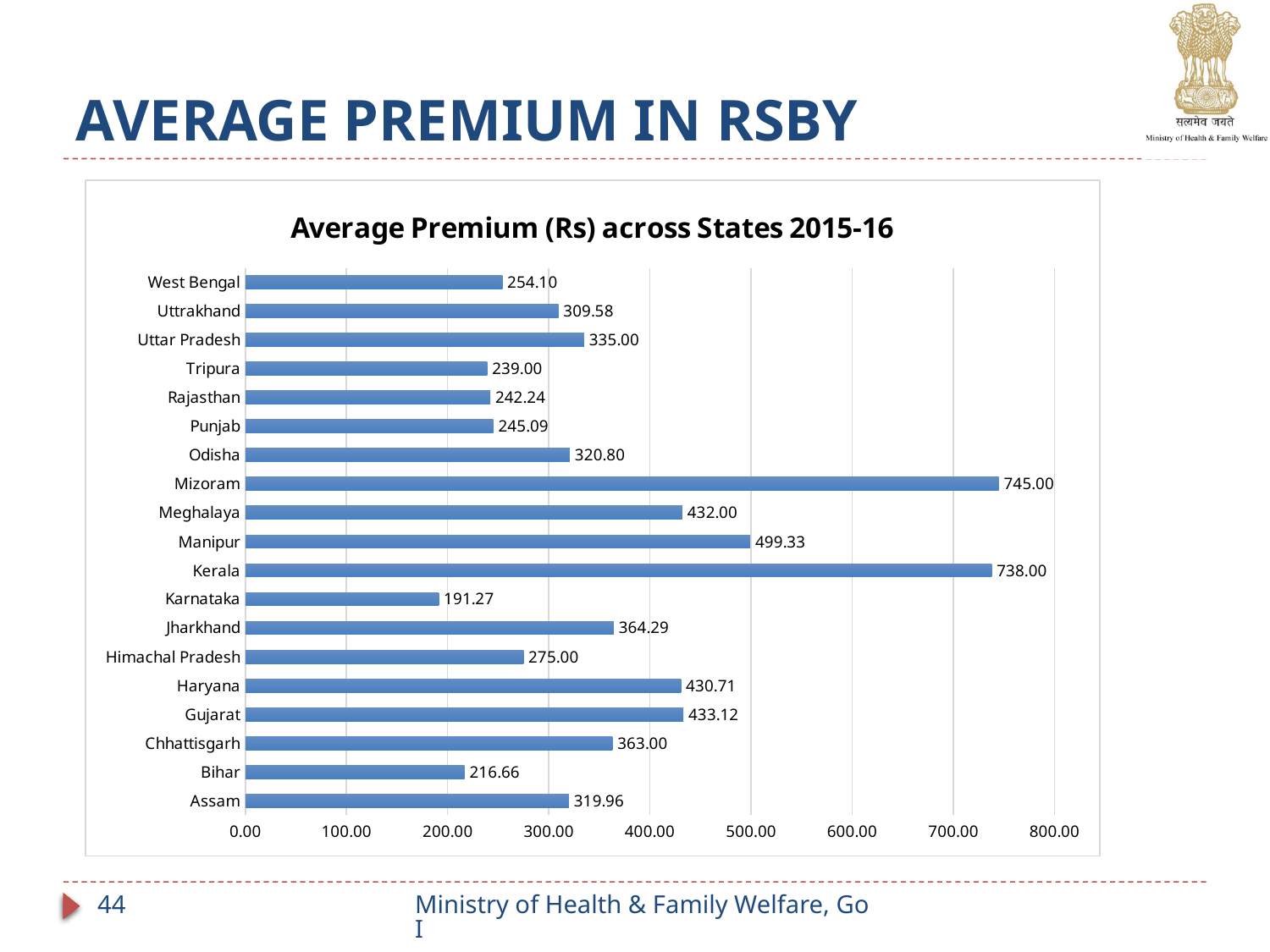
Is the average premium for Jharkhand greater or less than 300.00? greater What is the average premium for Manipur? 499.33 Which state has the highest average premium? Mizoram What is the average premium for Bihar? 216.66 Which has a higher average premium, Manipur or Meghalaya? Manipur What kind of chart is shown on the slide? Bar chart What is the difference between the average premium for Uttar Pradesh and Uttrakhand? 25.42 What is the difference between the average premium for Mizoram and Kerala? 7.00 How many states are shown in the chart? 19 Which state has the lowest average premium? Karnataka What is the average premium for Kerala? 738.00 What is the title of the chart? Average Premium (Rs) across States 2015-16